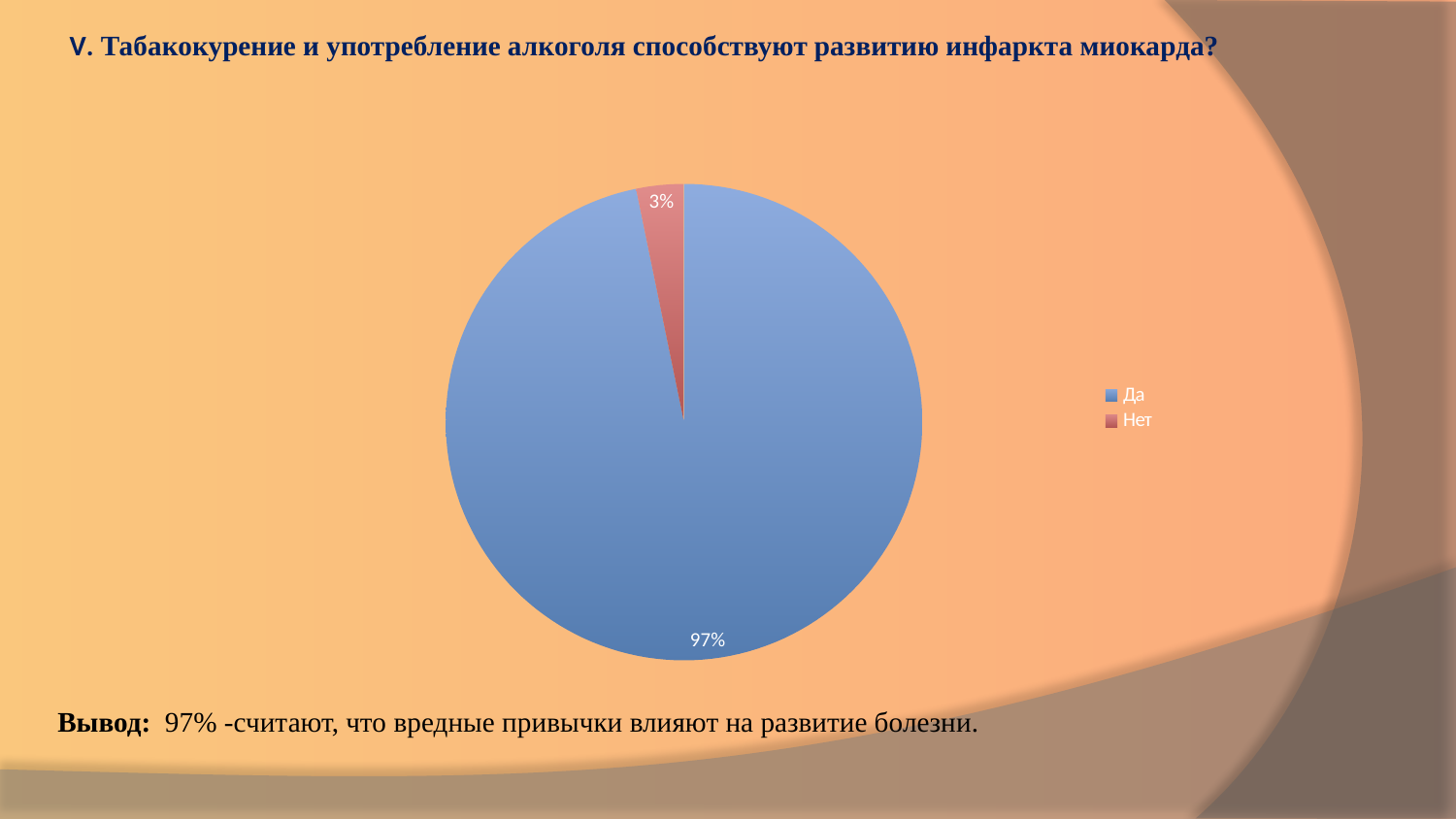
What is the difference in percentage points between the "Да" and "Нет" slices? 94 What share of the pie does the "Да" slice take? 97% How many entries does the legend list? 2 What percentage of the pie is labelled "Нет"? 3% Which slice of the pie is the smallest? Нет Which is larger, the "Да" slice or the "Нет" slice? Да What colour is the "Да" slice in the pie chart? blue What kind of chart is shown on the slide? pie chart What percentage of the pie is labelled "Да"? 97% What colour is the "Нет" slice in the pie chart? red Which slice of the pie is the largest? Да How many slices does the pie chart have? 2